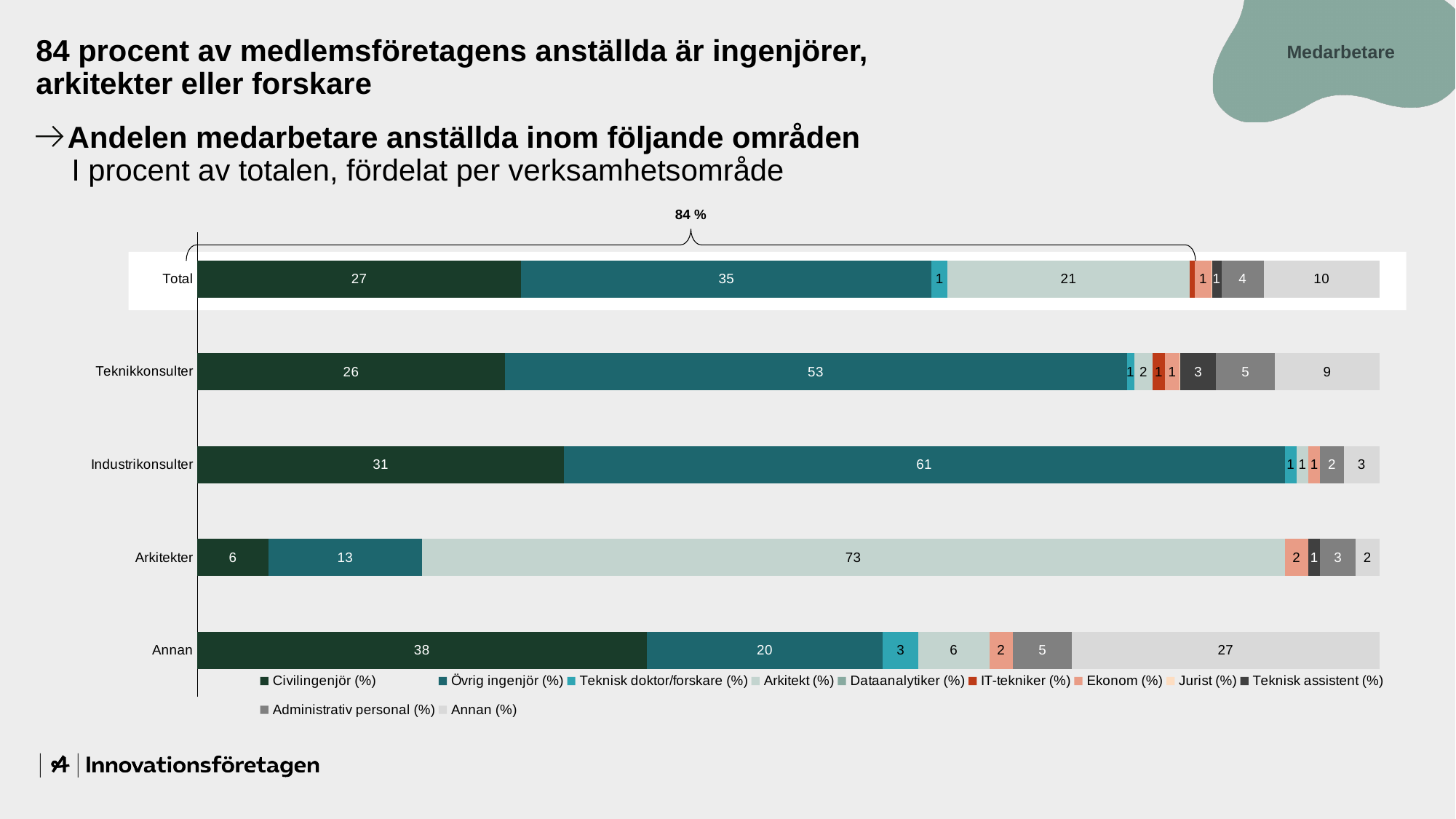
What is the Övrig ingenjör (%) value for Teknikkonsulter? 53 Which has a larger Arkitekt (%) value, Total or Annan? Total How many series does the legend list? 11 Which category has the highest Civilingenjör (%) value? Annan What kind of chart is shown on the slide? Stacked bar chart How many categories are shown on the chart? 5 Which category has the lowest Civilingenjör (%) value? Arkitekter What is the Annan (%) value for the Annan category? 27 What is the Civilingenjör (%) value for Total? 27 What is the difference between the Civilingenjör (%) values for Industrikonsulter and Teknikkonsulter? 5 What is the Arkitekt (%) value for Arkitekter? 73 What is the Övrig ingenjör (%) value for Industrikonsulter? 61